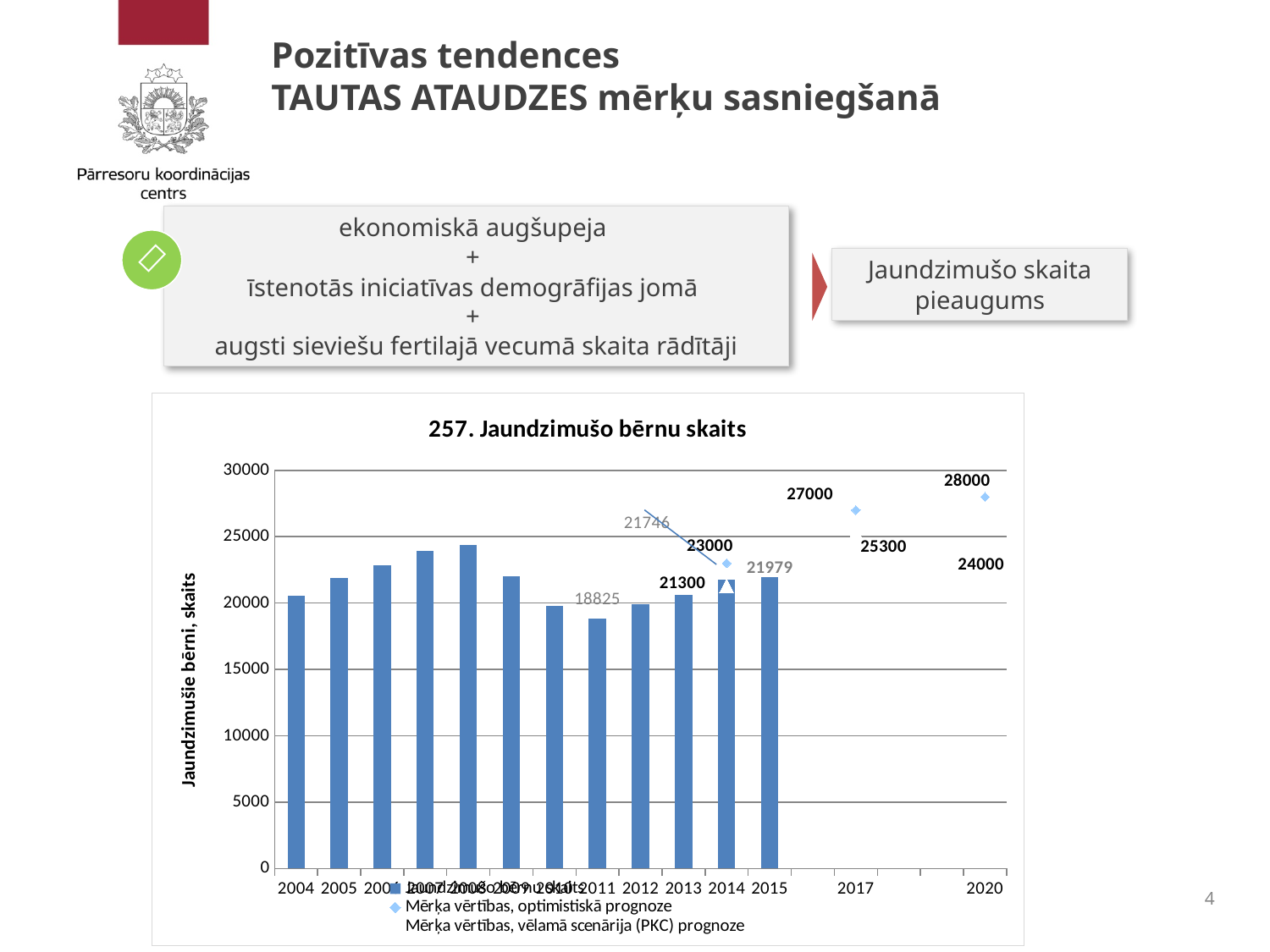
What is the number of newborn children shown for 2015? 21979 Which year has the lowest bar in the chart? 2011 What is the difference between the 2015 value and the 2011 value? 3154 What is the PKC scenario target value for 2017? 25300 How many years have a bar plotted in the chart? 12 What is the optimistic forecast target value (Mērķa vērtības, optimistiskā prognoze) for 2020? 28000 How many series does the chart legend list? 3 What kind of chart is shown on the slide? bar chart What is the title of the chart? 257. Jaundzimušo bērnu skaits Is the bar value for 2005 greater or less than 20000? greater What is the number of newborn children shown for 2011? 18825 Do the bar values rise or fall from 2011 to 2015? rise